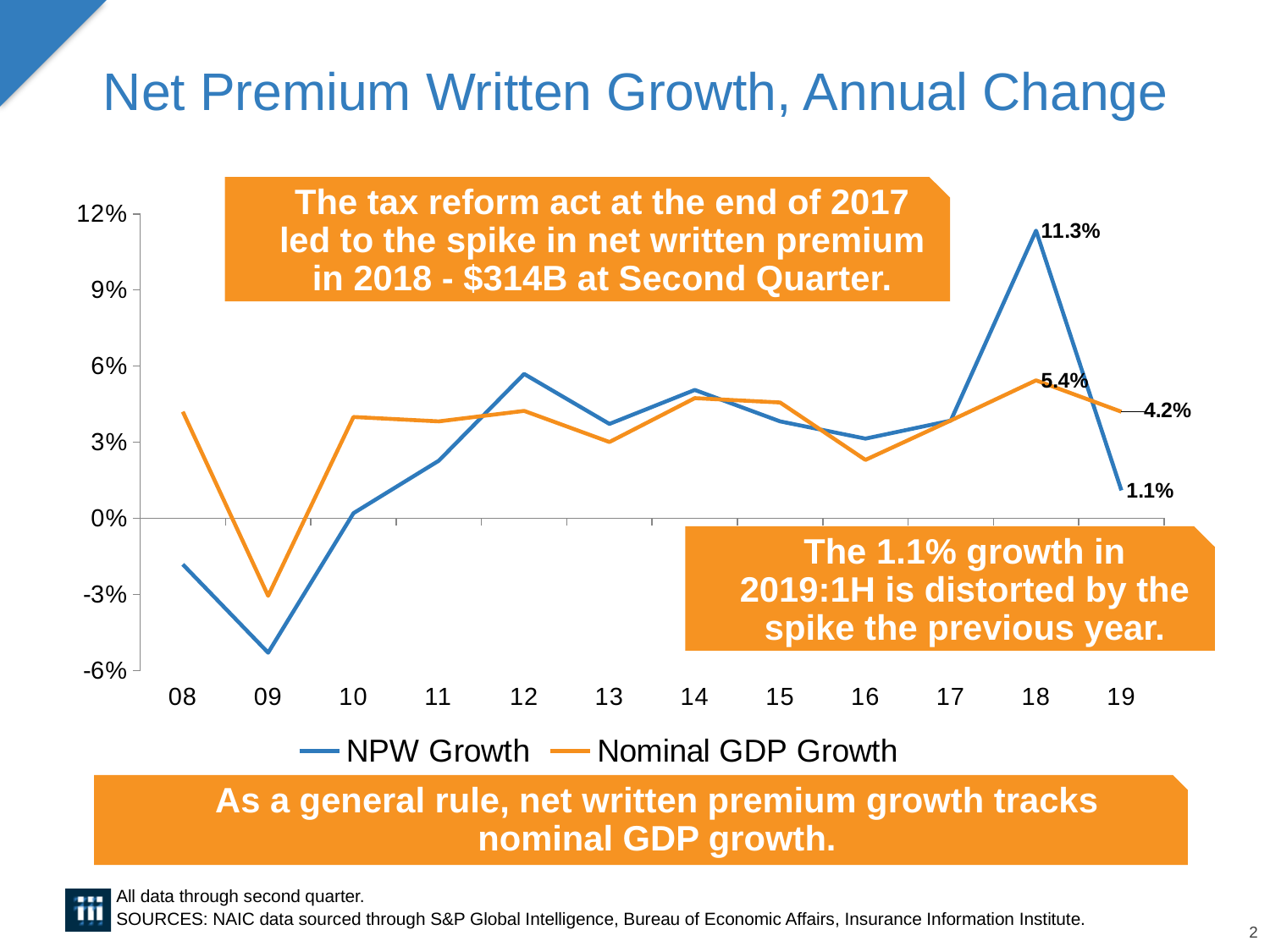
By how much did NPW Growth fall from 18 to 19? 10.2 percentage points What kind of chart is shown on the slide? Line chart What is the NPW Growth value for 19? 1.1% How many years are plotted along the x axis? 12 What is the NPW Growth value for 18? 11.3% What is the difference between NPW Growth and Nominal GDP Growth in 18? 5.9 percentage points In which year is NPW Growth lowest? 09 How many series does the legend list? 2 What is the Nominal GDP Growth value for 18? 5.4% In which year is NPW Growth highest? 18 What is the Nominal GDP Growth value for 19? 4.2% Is the NPW Growth value for 09 greater or less than -3%? less